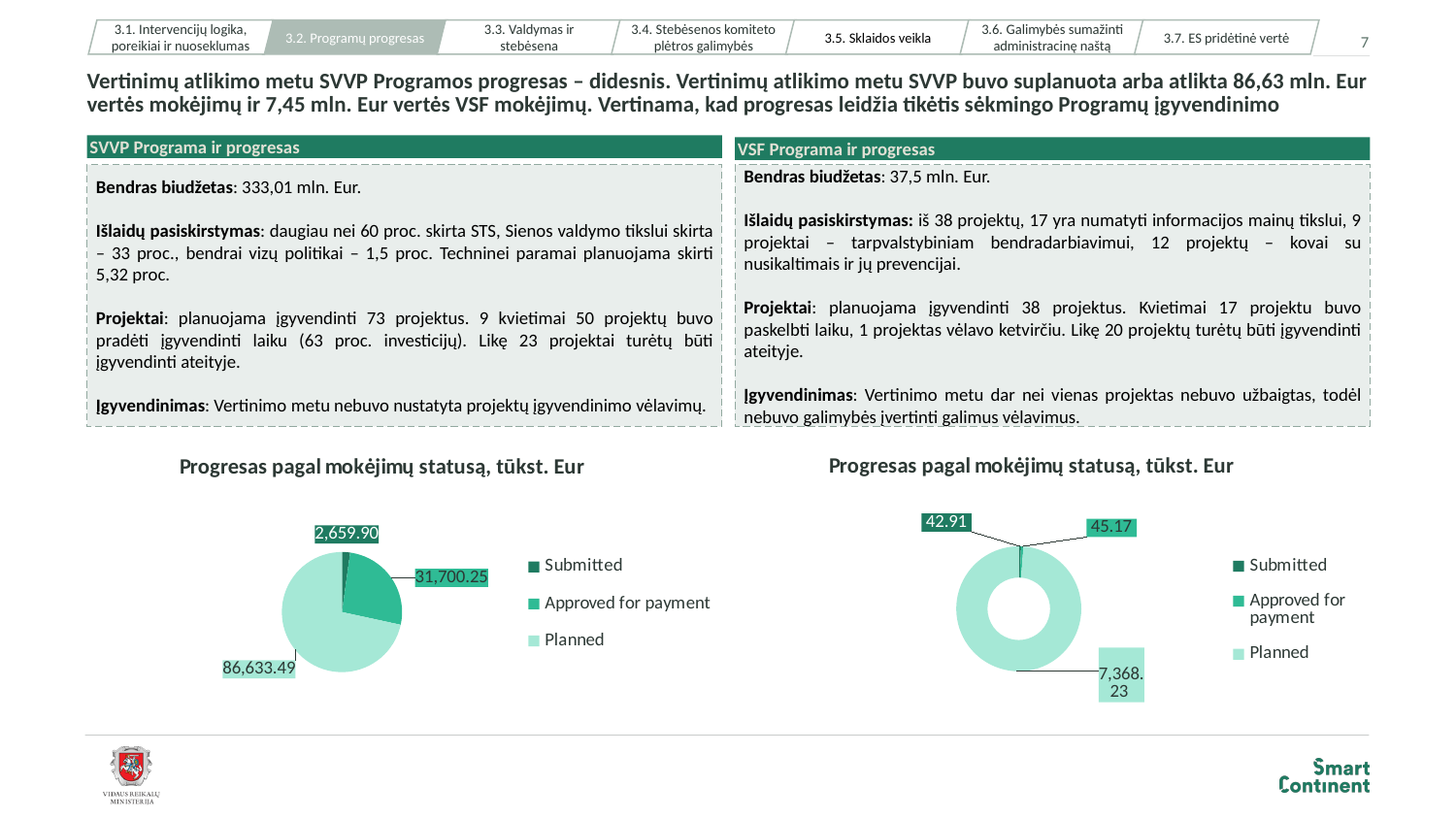
In the left pie chart, what is the value for Submitted? 2,659.90 In the right doughnut chart, what is the value for Planned? 7,368.23 In the right doughnut chart, what is the value for Approved for payment? 45.17 In the right doughnut chart, what is the difference between Approved for payment and Submitted? 2.26 In the left pie chart, what is the value for Planned? 86,633.49 In the left pie chart, which category has the smallest value? Submitted In the right doughnut chart, what is the value for Submitted? 42.91 In the left pie chart, what is the difference between Planned and Approved for payment? 54,933.24 How many categories does the legend of the left pie chart list? 3 In the left pie chart, which category has the largest value? Planned In the right doughnut chart, which is larger: Planned or Approved for payment? Planned In the left pie chart, what is the value for Approved for payment? 31,700.25